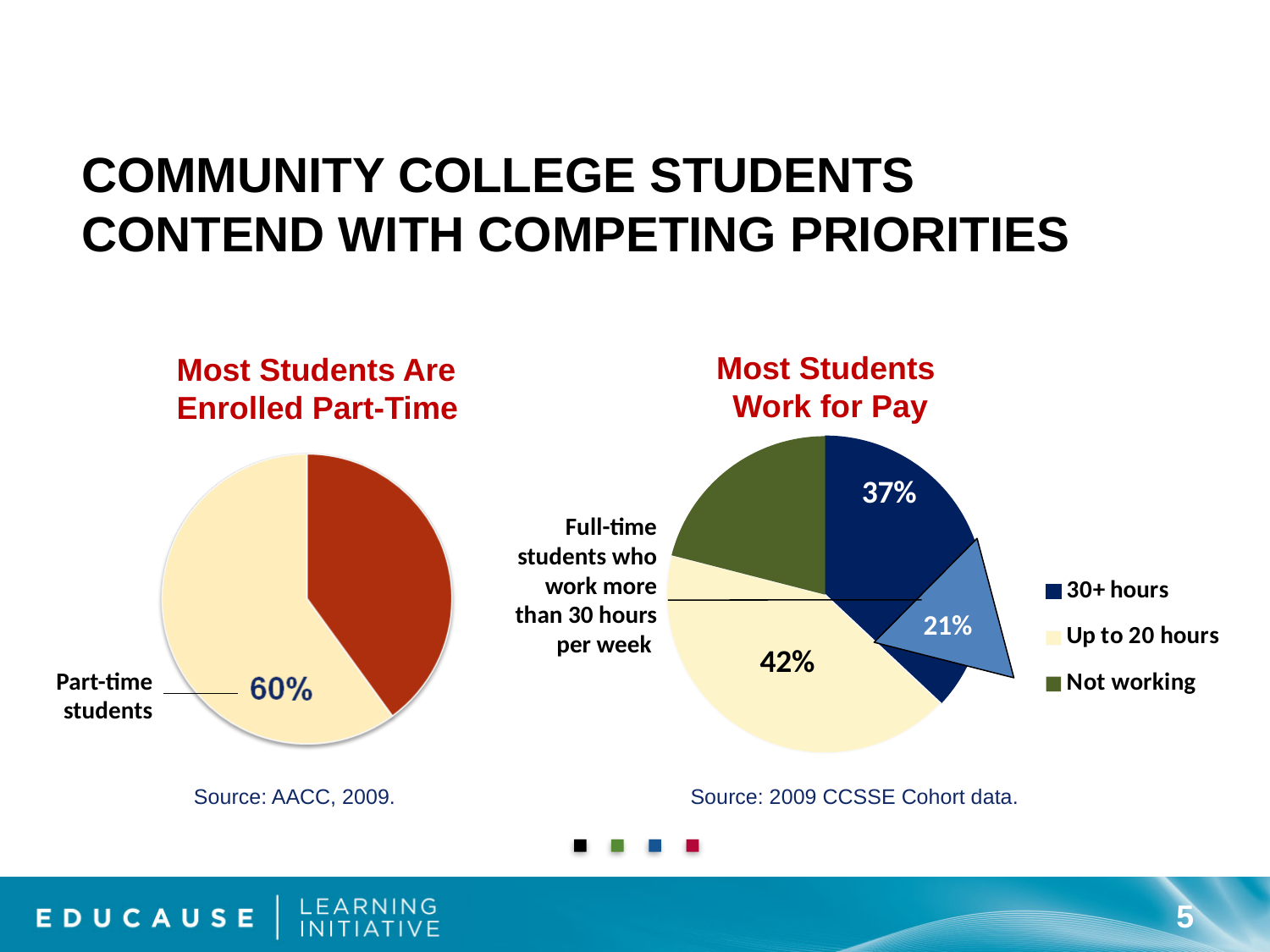
In the 'Most Students Work for Pay' chart, which is larger, 30+ hours or Up to 20 hours? Up to 20 hours In the 'Most Students Work for Pay' chart, what percentage is labelled for full-time students who work more than 30 hours per week? 21% What source is cited below the 'Most Students Are Enrolled Part-Time' chart? AACC, 2009 What kind of chart is the 'Most Students Are Enrolled Part-Time' chart? Pie chart In the 'Most Students Work for Pay' chart, what is the difference between the Up to 20 hours share and the 30+ hours share? 5 percentage points In the 'Most Students Work for Pay' chart, what percentage is shown for 30+ hours? 37% In the 'Most Students Work for Pay' chart, which legend category has the smallest slice? Not working In the 'Most Students Are Enrolled Part-Time' chart, which slice is larger, the part-time students slice or the other slice? Part-time students How many slices does the 'Most Students Are Enrolled Part-Time' pie chart have? 2 In the 'Most Students Work for Pay' chart, what percentage is shown for Up to 20 hours? 42% How many entries does the legend of the 'Most Students Work for Pay' chart list? 3 In the 'Most Students Are Enrolled Part-Time' chart, what share of the pie is labelled for part-time students? 60%